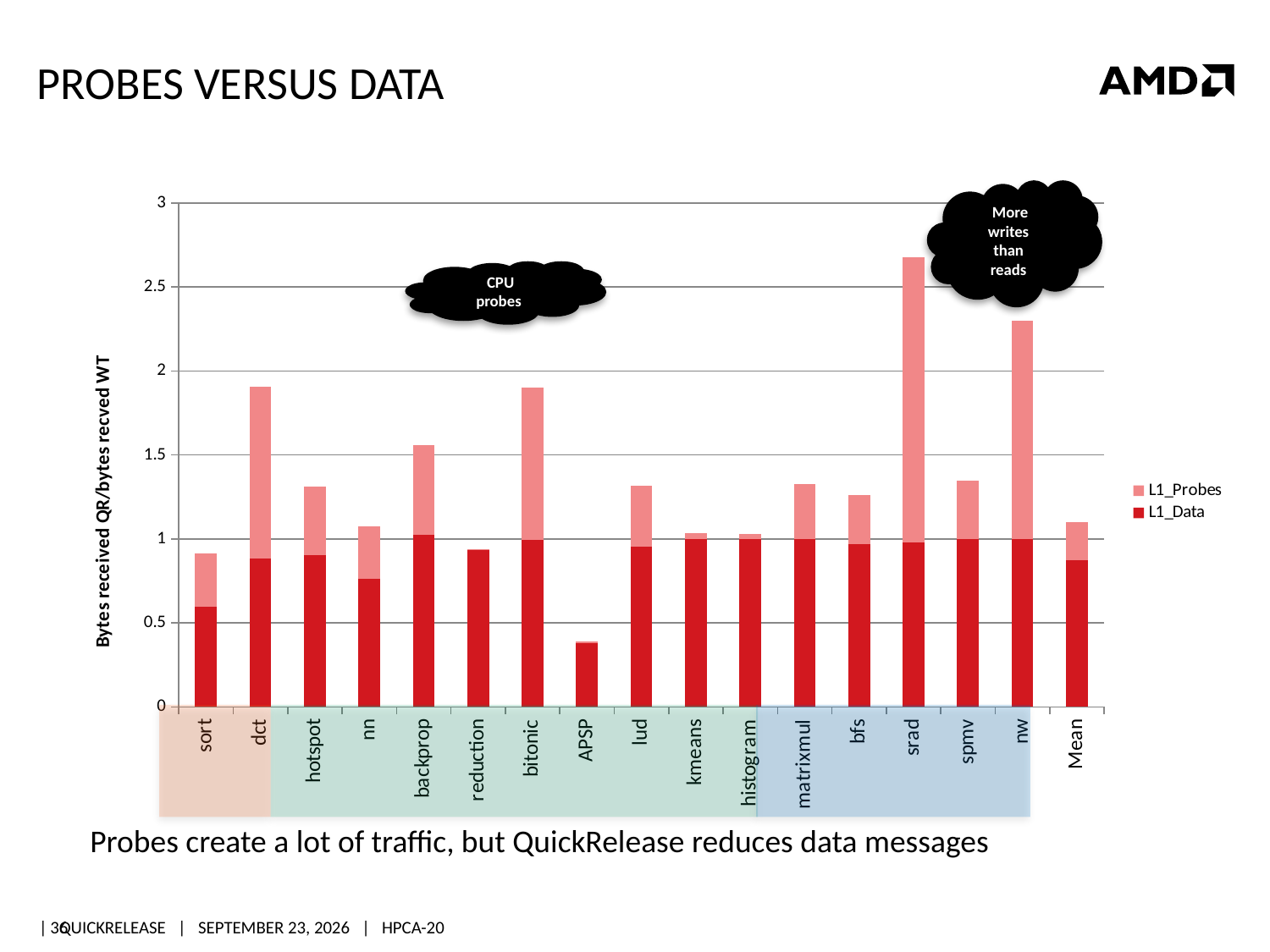
How many categories are shown along the x axis of the chart? 17 How many series does the legend list? 2 Which category has the lowest total bar? APSP Which has the larger total bar, dct or hotspot? dct Is the total value for srad greater or less than 2.5? greater Which category has the highest total bar? srad What are the two series named in the legend? L1_Probes and L1_Data Is the total value for dct greater or less than 1.5? greater Is the total value for APSP greater or less than 0.5? less What kind of chart is shown on the slide? stacked bar chart Which has the larger total bar, srad or nw? srad